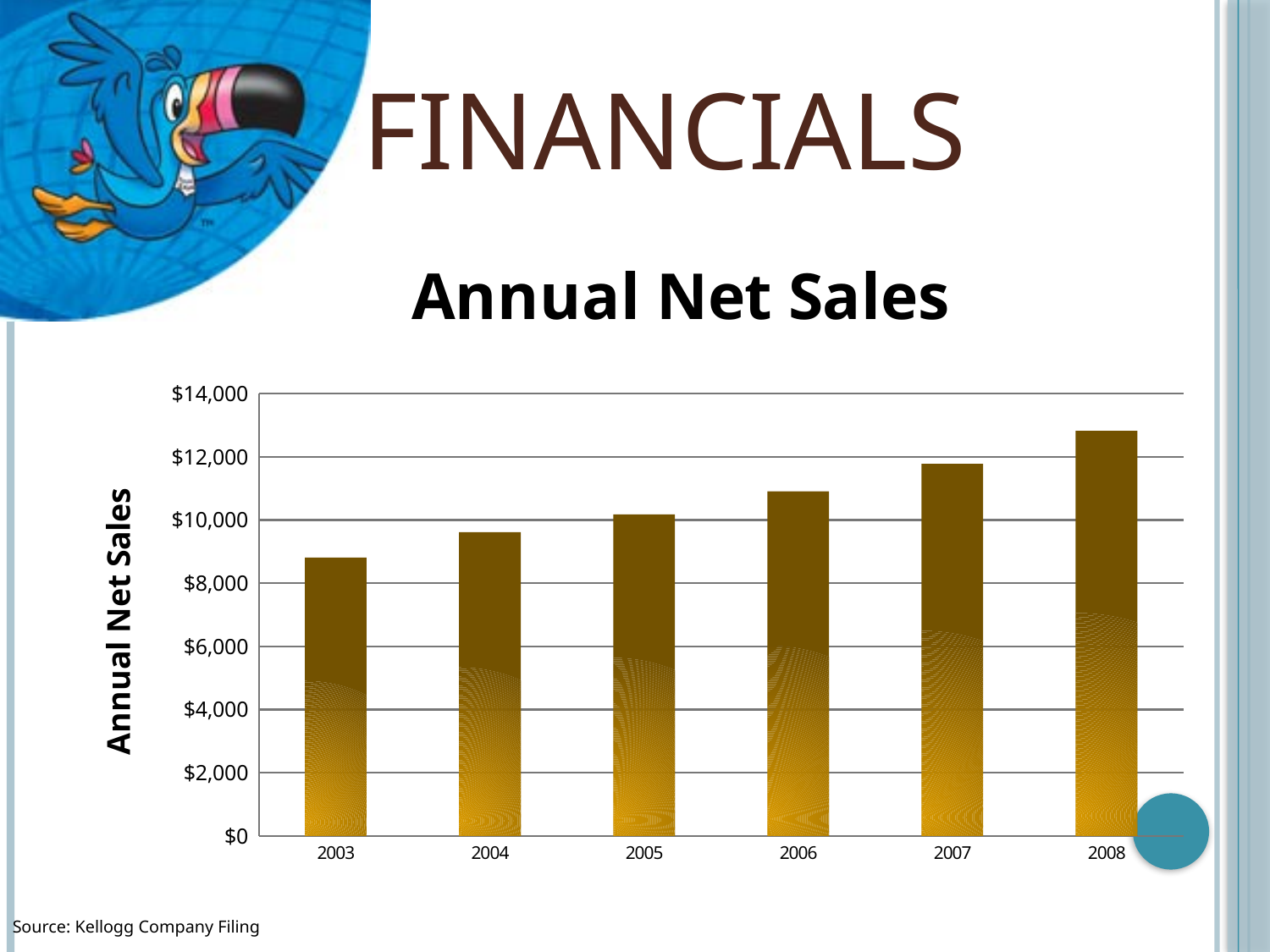
Is the value for 2003 greater or less than $10,000? less Is the value for 2004 greater or less than $10,000? less Do annual net sales rise or fall from 2003 to 2008? rise Which year has the highest annual net sales? 2008 What kind of chart is shown on the slide? bar chart Which year has larger annual net sales, 2005 or 2007? 2007 How many years are shown on the x axis of the Annual Net Sales chart? 6 Which year has the lowest annual net sales? 2003 What is the label on the vertical axis of the chart? Annual Net Sales Is the value for 2007 greater or less than $10,000? greater What is the title of the chart? Annual Net Sales